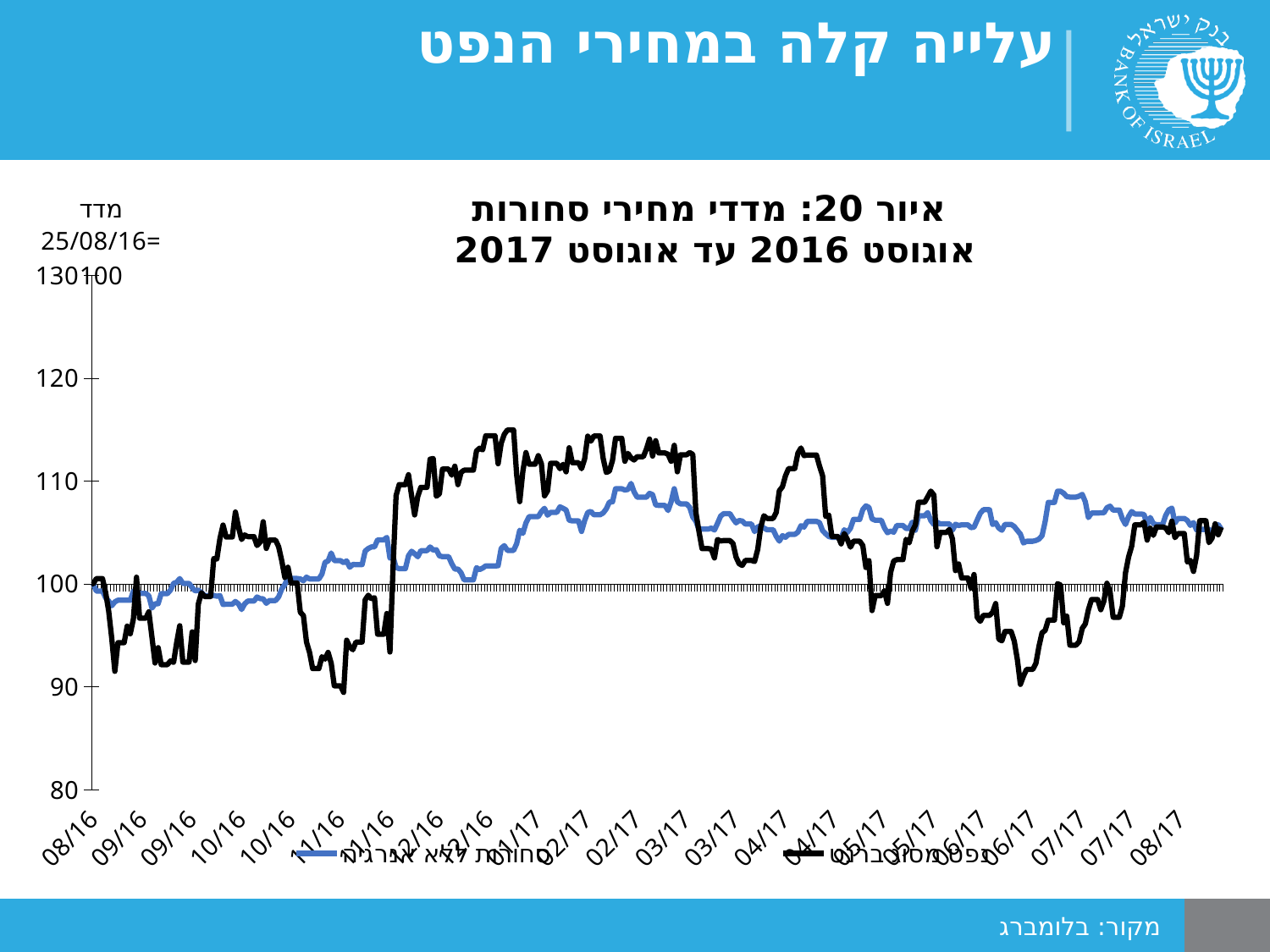
Around 06/17, which line is higher: the black line (נפט מסוג ברנט) or the blue line (סחורות ללא אנרגיה)? the blue line (סחורות ללא אנרגיה) Is the value of the blue line (סחורות ללא אנרגיה) around 03/17 greater or less than 100? greater What kind of chart is shown on the slide? line chart Is the value of the black line (נפט מסוג ברנט) around 11/16 greater or less than 100? less What base date is the index set to 100 on, according to the axis note? 25/08/16 What is the title of the chart? איור 20: מדדי מחירי סחורות אוגוסט 2016 עד אוגוסט 2017 How many series does the legend list? 2 Is the value of the blue line (סחורות ללא אנרגיה) around 09/16 greater or less than 110? less What is the highest value shown on the y axis? 130 Around 01/17, which line is higher: the black line (נפט מסוג ברנט) or the blue line (סחורות ללא אנרגיה)? the black line (נפט מסוג ברנט)